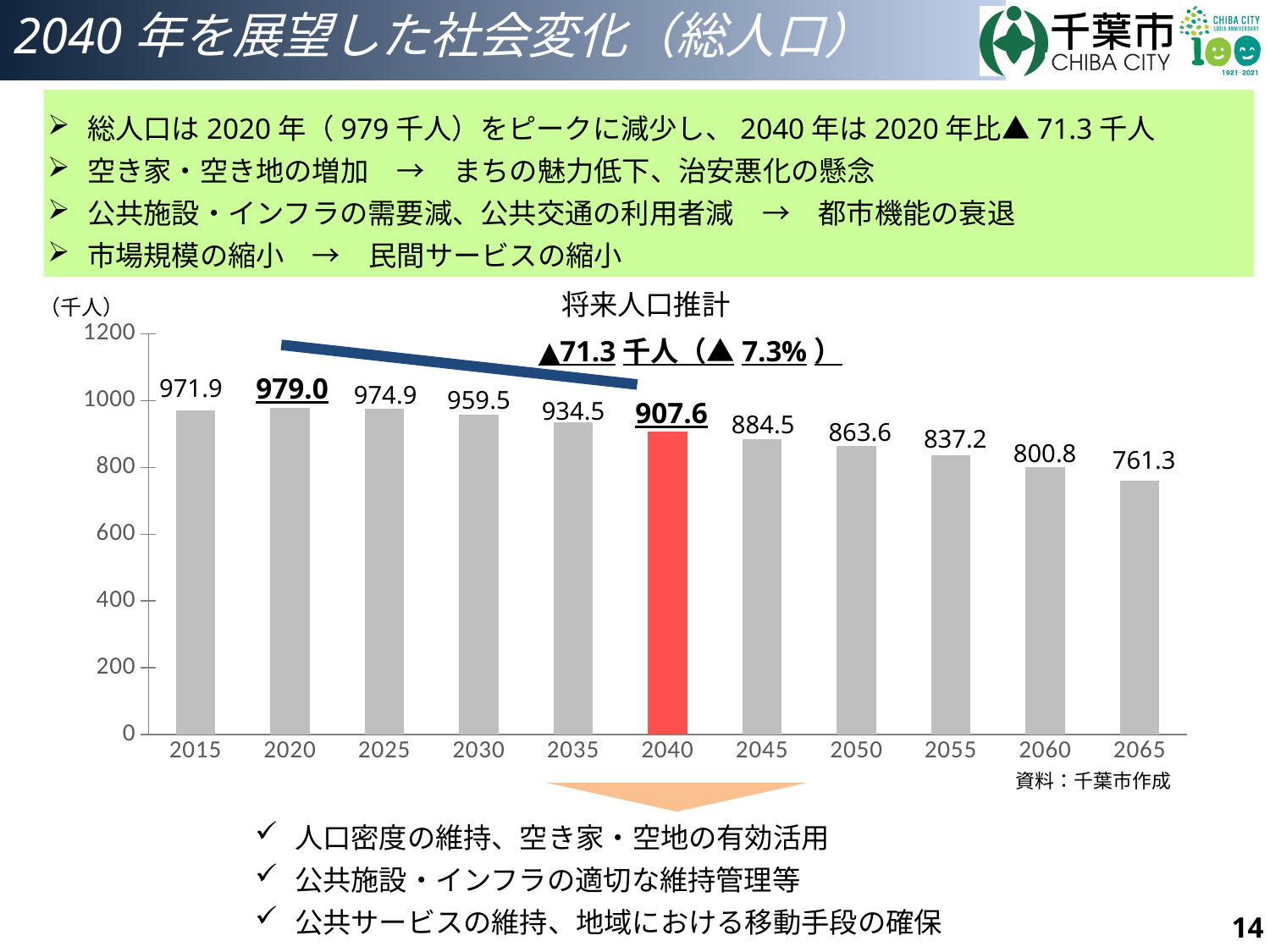
What is the value for 2020 in the 将来人口推計 chart? 979.0 How many years are plotted in the 将来人口推計 chart? 11 Which year has the highest value in the 将来人口推計 chart? 2020 What is the value for 2040 in the 将来人口推計 chart? 907.6 Which is larger in the 将来人口推計 chart, the value for 2015 or the value for 2025? 2025 Is the value for 2060 in the 将来人口推計 chart greater or less than 1000? less What kind of chart is the 将来人口推計 chart? bar chart Which year has the lowest value in the 将来人口推計 chart? 2065 What is the value for 2065 in the 将来人口推計 chart? 761.3 Which year's bar is highlighted in red in the 将来人口推計 chart? 2040 Do the values in the 将来人口推計 chart rise or fall from 2020 to 2065? fall